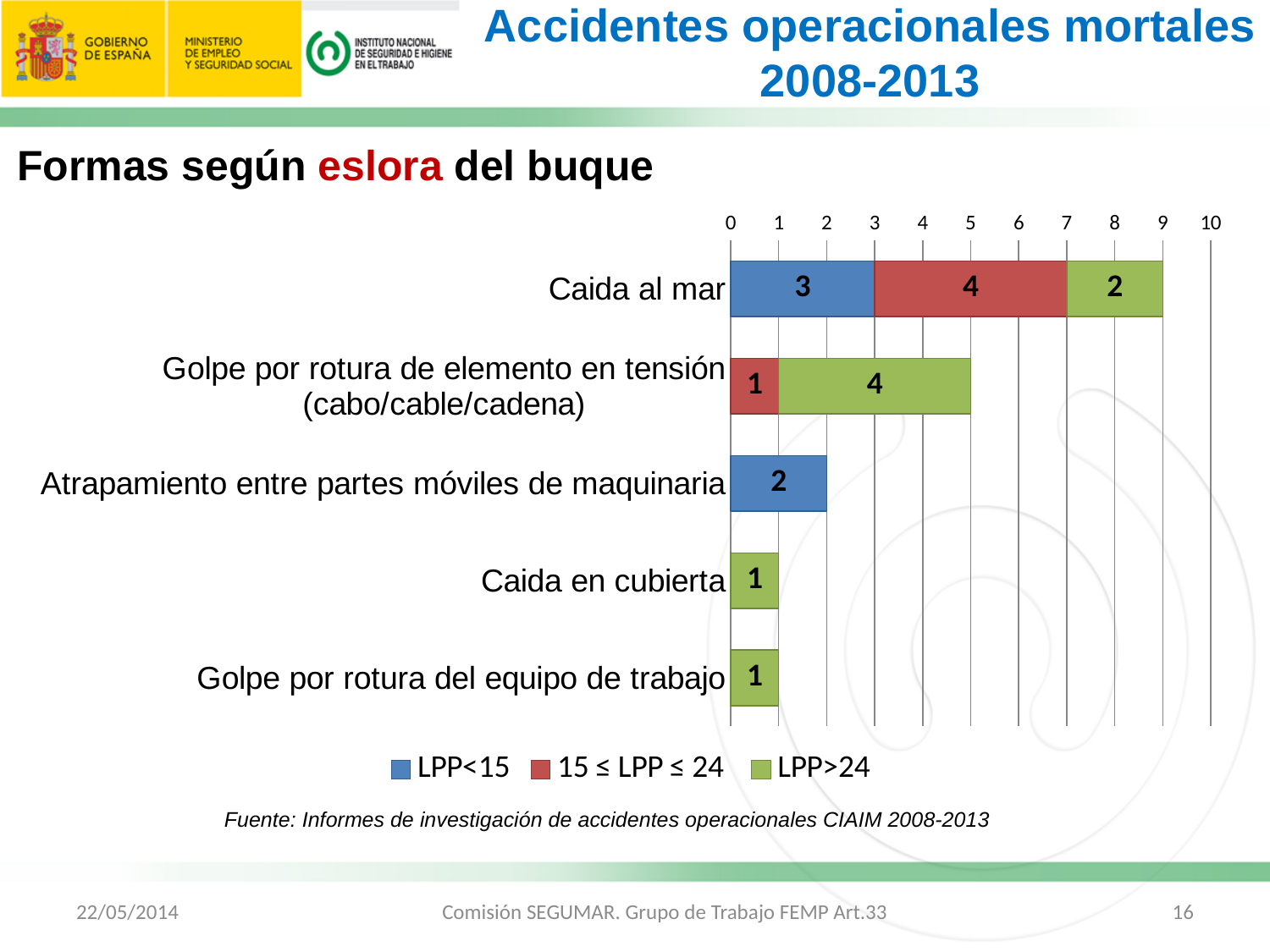
What is the difference between the LPP>24 value for 'Golpe por rotura de elemento en tensión (cabo/cable/cadena)' and the LPP>24 value for 'Caida al mar'? 2 How many accident categories are shown on the chart? 5 What is the total of the stacked bar for 'Caida al mar'? 9 How many series does the legend list? 3 What is the value for LPP>24 in the 'Golpe por rotura de elemento en tensión (cabo/cable/cadena)' category? 4 Which category has the highest total number of fatal accidents? Caida al mar What kind of chart is shown on the slide? Stacked bar chart Which series is shown in green in the legend? LPP>24 What is the value for LPP<15 in the 'Atrapamiento entre partes móviles de maquinaria' category? 2 What is the value for LPP<15 in the 'Caida al mar' category? 3 What is the total of the stacked bar for 'Golpe por rotura de elemento en tensión (cabo/cable/cadena)'? 5 What is the value for 15 ≤ LPP ≤ 24 in the 'Caida al mar' category? 4